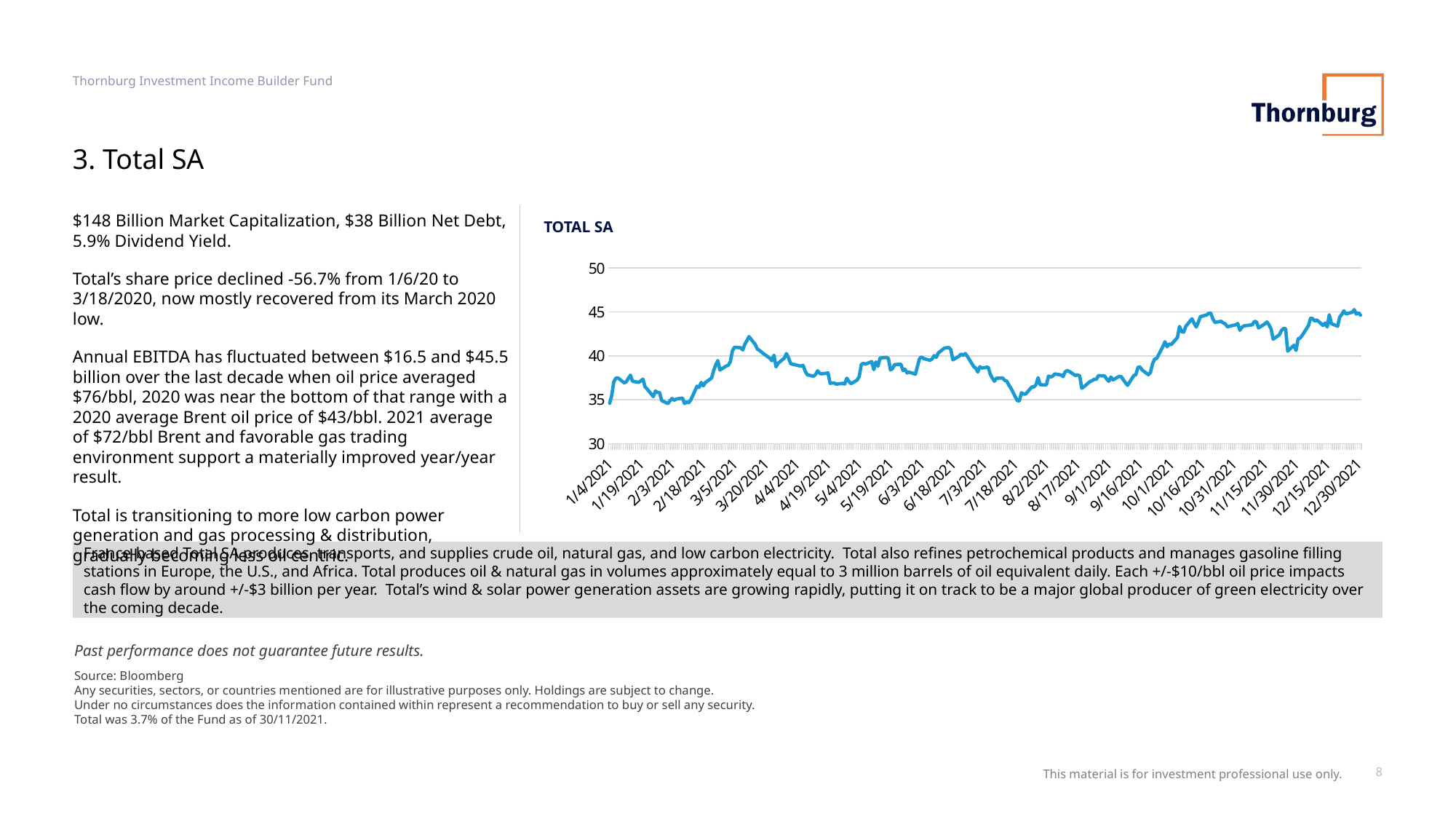
Is the value for 7/18/2021 greater or less than 40? less Is the value for 10/16/2021 greater or less than 40? greater Is the value for 3/5/2021 greater or less than 35? greater What is the title of the chart? TOTAL SA Overall, does the plotted value rise or fall from 1/4/2021 to 12/30/2021? rise What is the highest value shown on the vertical axis of the chart? 50 What kind of chart is shown on the slide? line chart Which is larger, the value for 12/30/2021 or the value for 1/4/2021? 12/30/2021 Which is larger, the value for 10/16/2021 or the value for 5/4/2021? 10/16/2021